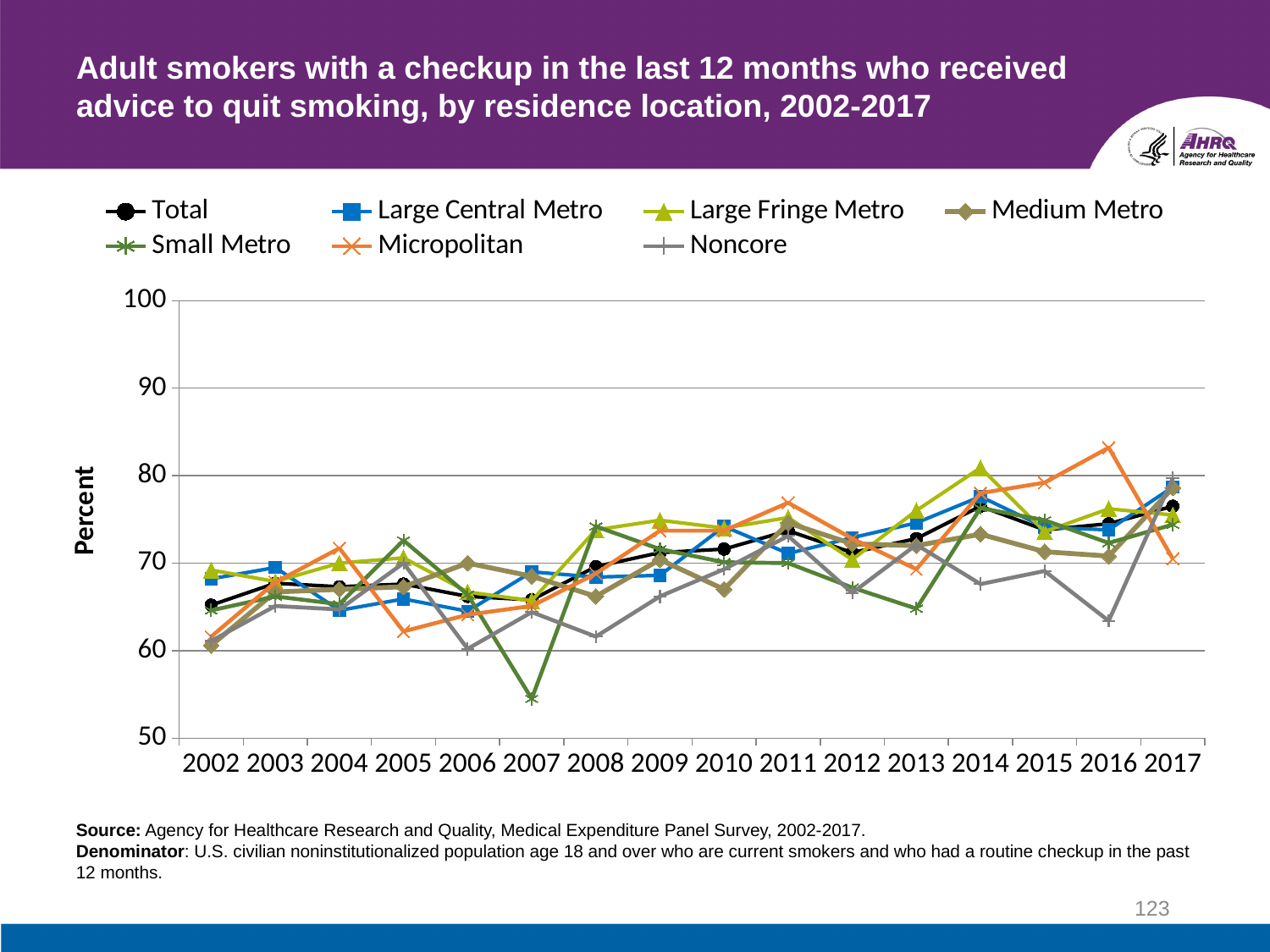
Is the value for Micropolitan in 2016 greater or less than 80? greater Which series has the highest value in 2016? Micropolitan Which series has the lowest value in 2007? Small Metro Is the value for Total in 2002 greater or less than 70? less What is the label of the y axis? Percent How many years are plotted along the x axis? 16 In 2016, which is larger: the value for Micropolitan or the value for Noncore? Micropolitan Is the value for Small Metro in 2007 greater or less than 60? less How many series does the legend list? 7 Does the Total series generally rise or fall from 2002 to 2017? Rise Which series has the highest value in 2014? Large Fringe Metro What kind of chart is shown on the slide? Line chart